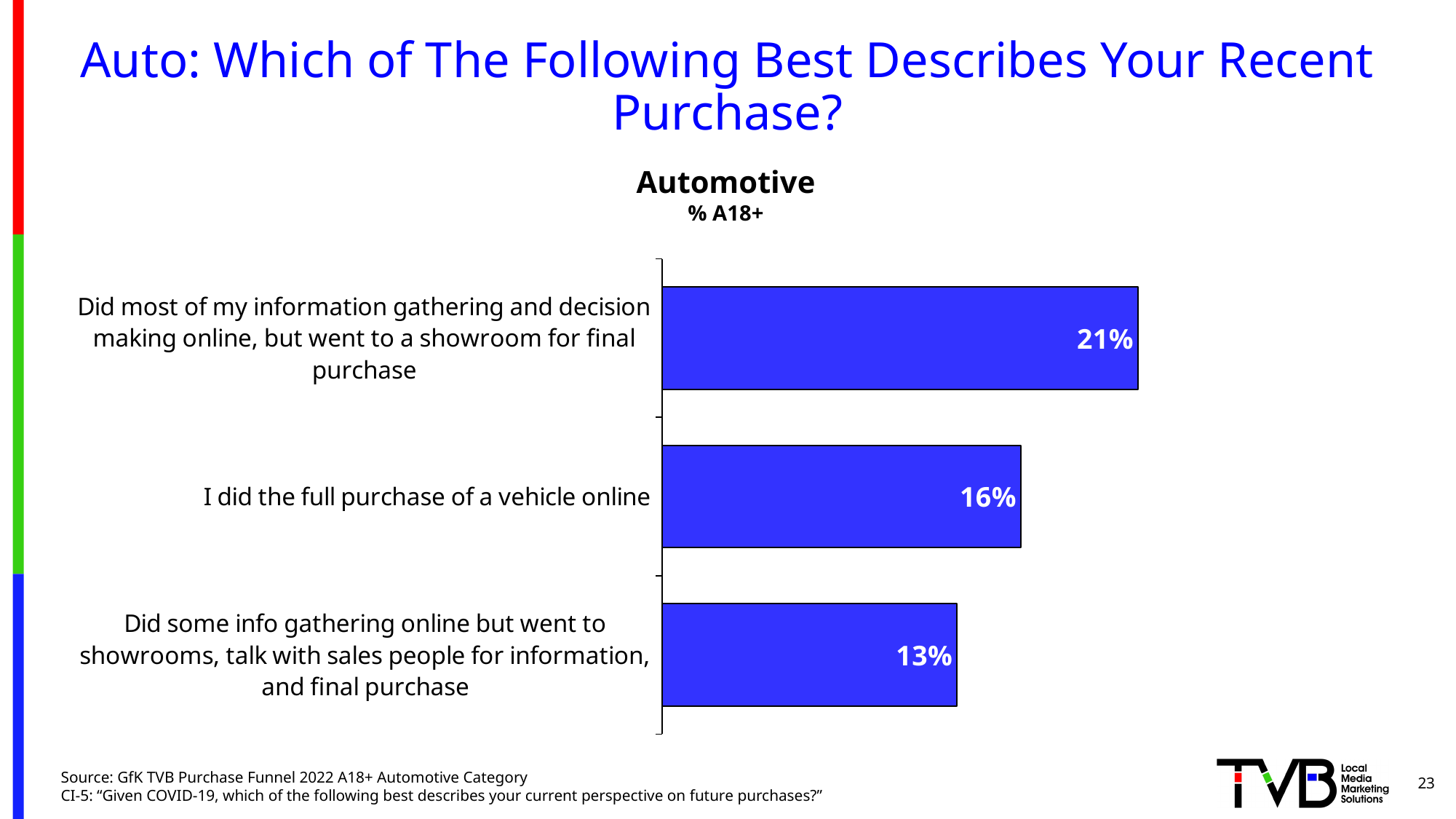
What is the value for 'Did most of my information gathering and decision making online, but went to a showroom for final purchase'? 21% What type of chart is shown on the slide? Bar chart What is the title of the chart? Automotive Which category has the lowest value? Did some info gathering online but went to showrooms, talk with sales people for information, and final purchase Which is larger: the value for 'I did the full purchase of a vehicle online' or the value for 'Did most of my information gathering and decision making online, but went to a showroom for final purchase'? Did most of my information gathering and decision making online, but went to a showroom for final purchase How many percentage points higher is 'I did the full purchase of a vehicle online' than 'Did some info gathering online but went to showrooms, talk with sales people for information, and final purchase'? 3 What percentage of A18+ said they did the full purchase of a vehicle online? 16% What is the difference in percentage points between the highest and lowest categories? 8 Which category has the highest value? Did most of my information gathering and decision making online, but went to a showroom for final purchase How many categories are shown in the chart? 3 What is the value for 'Did some info gathering online but went to showrooms, talk with sales people for information, and final purchase'? 13% What is the subtitle shown under the chart title? % A18+